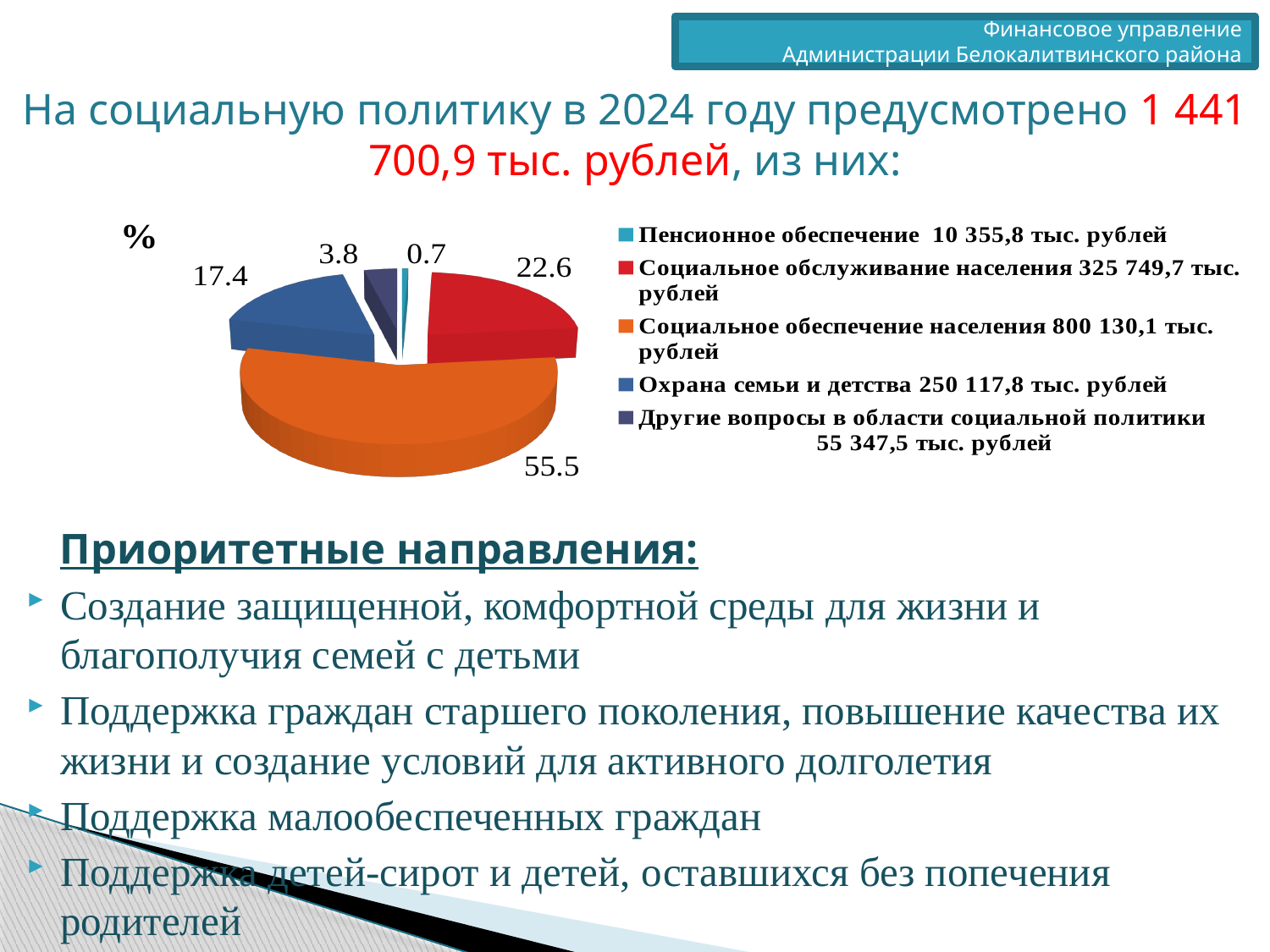
What percentage share does the slice for Социальное обеспечение населения have? 55.5 What percentage share does the slice for Охрана семьи и детства have? 17.4 How many entries does the legend of the pie chart list? 5 Which category has the largest slice of the pie chart? Социальное обеспечение населения What percentage share does the slice for Пенсионное обеспечение have? 0.7 How many slices does the pie chart have? 5 What kind of chart is shown on the slide? pie chart According to the legend, what amount in тыс. рублей is allocated to Охрана семьи и детства? 250 117,8 тыс. рублей Which slice is larger: Охрана семьи и детства or Другие вопросы в области социальной политики? Охрана семьи и детства What is the difference in percentage points between the slices for Социальное обеспечение населения and Социальное обслуживание населения? 32.9 Which category has the smallest slice of the pie chart? Пенсионное обеспечение What percentage share does the slice for Социальное обслуживание населения have? 22.6